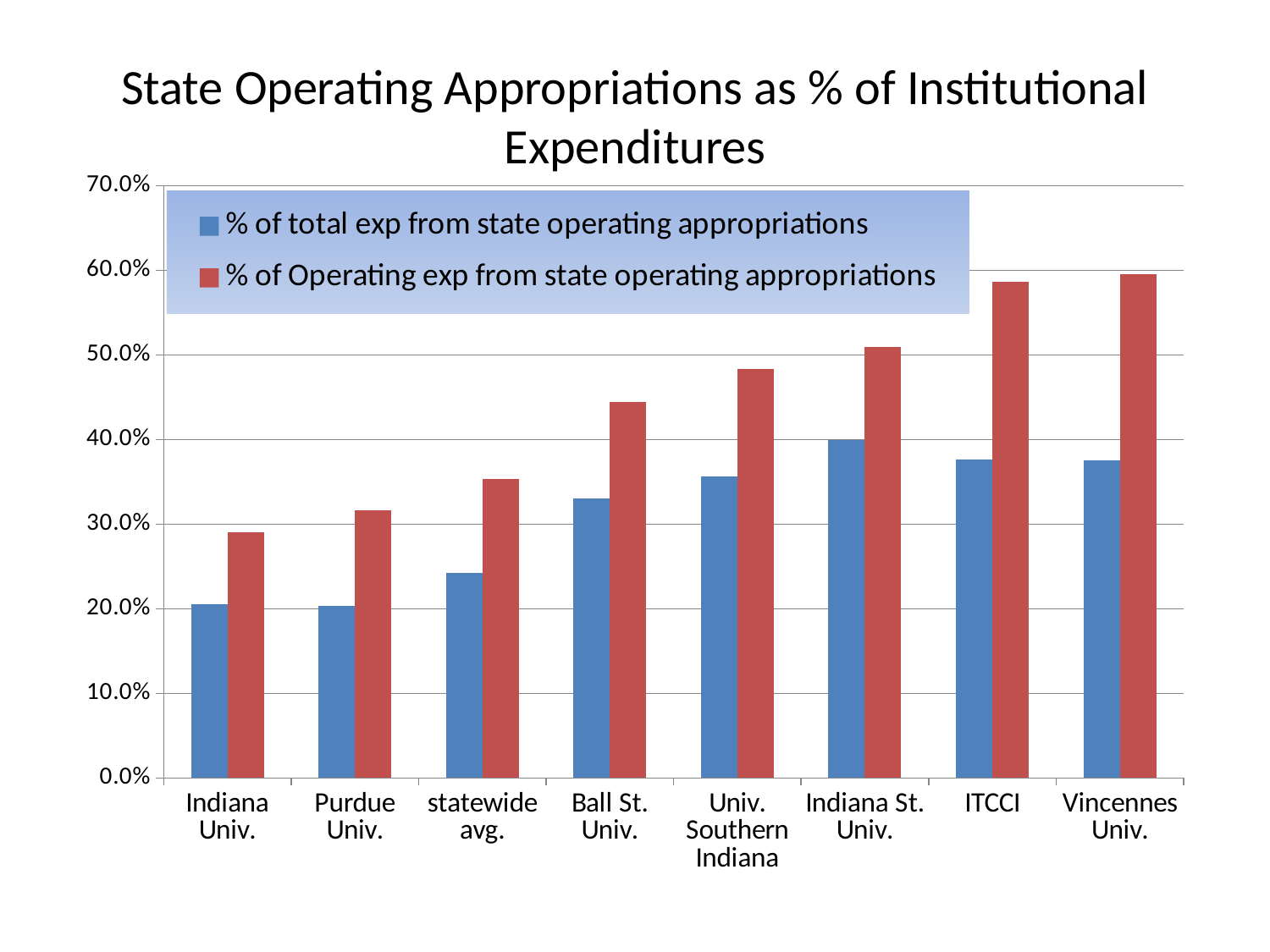
Is the value for Univ. Southern Indiana in the % of Operating exp from state operating appropriations series greater or less than 50.0%? less How many institutions/categories are shown on the x axis? 8 Is the value for statewide avg. in the % of total exp from state operating appropriations series greater or less than 30.0%? less Is the value for Vincennes Univ. in the % of Operating exp from state operating appropriations series greater or less than 50.0%? greater Which category has the highest value for % of total exp from state operating appropriations? Indiana St. Univ. What kind of chart is shown on the slide? bar chart What is the title of the chart? State Operating Appropriations as % of Institutional Expenditures For ITCCI, which series has the larger value: % of total exp from state operating appropriations or % of Operating exp from state operating appropriations? % of Operating exp from state operating appropriations Do the values for % of Operating exp from state operating appropriations rise or fall moving from Indiana Univ. to Vincennes Univ. along the x axis? rise How many series does the legend list? 2 Which category has the lowest value for % of Operating exp from state operating appropriations? Indiana Univ.